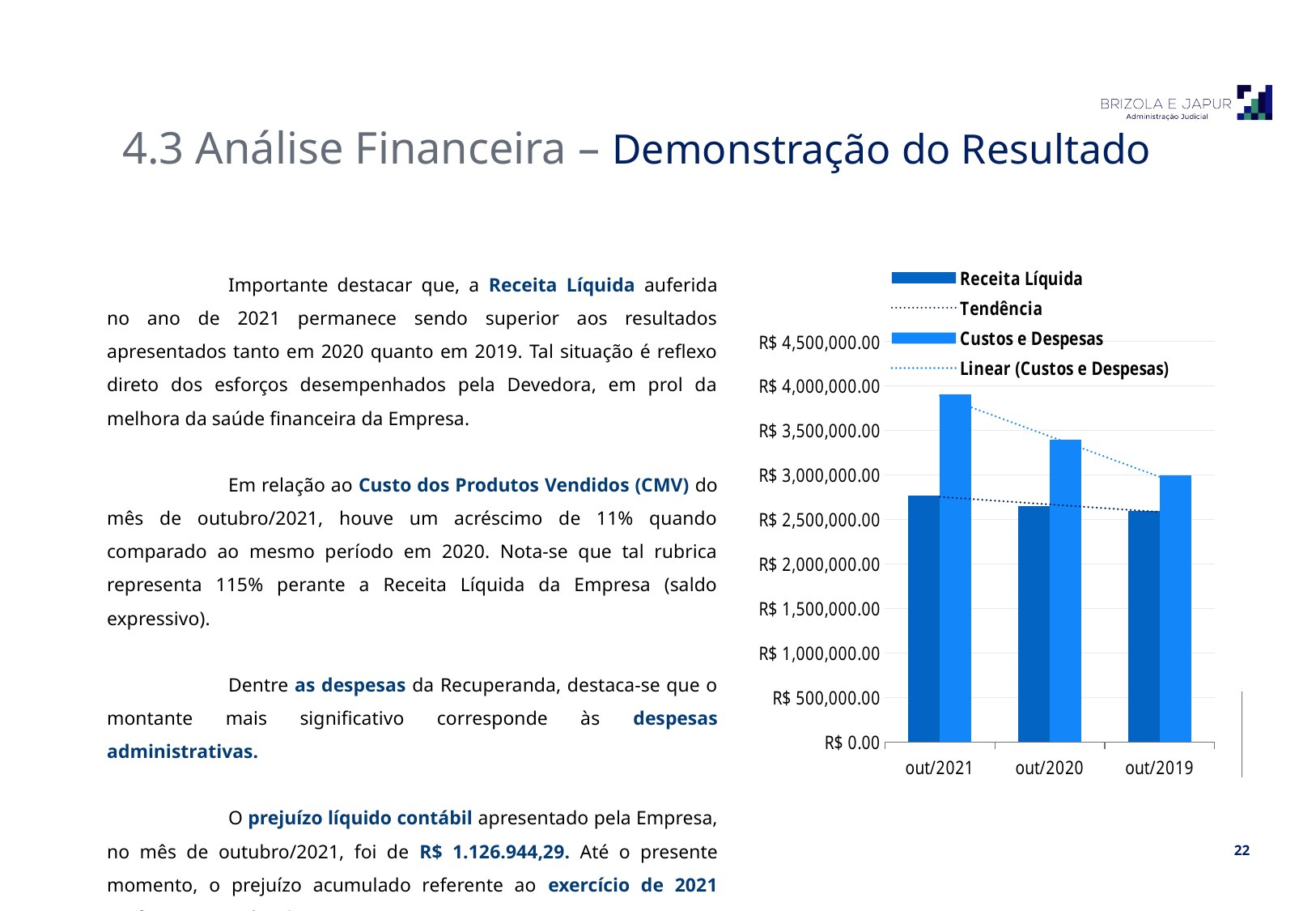
Do the Custos e Despesas values rise or fall moving from out/2021 to out/2019 along the x axis? fall Is the value for Custos e Despesas in out/2021 greater or less than R$ 3,500,000.00? greater Which category has the lowest value for Custos e Despesas? out/2019 In out/2021, which is larger: Receita Líquida or Custos e Despesas? Custos e Despesas Is the value for Receita Líquida in out/2021 greater or less than R$ 3,000,000.00? less How many entries does the chart legend list? 4 Which category has the highest value for Custos e Despesas? out/2021 Which legend entry is shown as a dotted blue line? Linear (Custos e Despesas) Is the value for Receita Líquida in out/2019 greater or less than R$ 2,000,000.00? greater What kind of chart is shown on the slide? Bar chart How many categories are shown on the x axis of the chart? 3